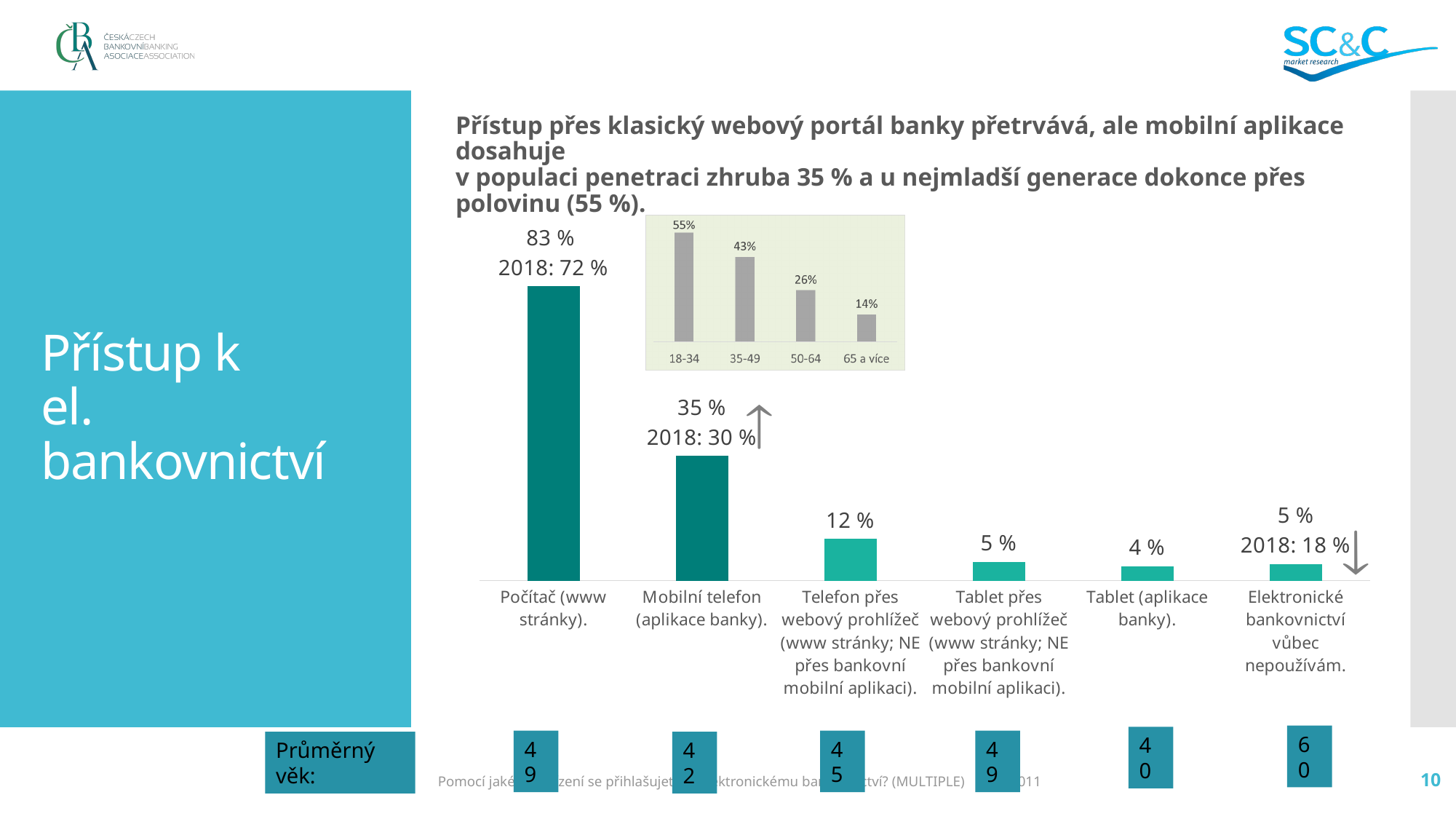
In the small inset chart, what is the value for the 18-34 age group? 55% In the main bar chart, what is the value for Mobilní telefon (aplikace banky)? 35 % What kind of chart is the main chart on the slide? Bar chart How many categories does the main bar chart show? 6 In the main bar chart, what was the 2018 value shown for Elektronické bankovnictví vůbec nepoužívám? 2018: 18 % In the small inset chart, which age group has the lowest value? 65 a více In the main bar chart, what is the difference between Počítač (www stránky) and Mobilní telefon (aplikace banky)? 48 % In the main bar chart, what is the value for Počítač (www stránky)? 83 % In the small inset chart, do the values rise or fall from 18-34 to 65 a více? Fall In the main bar chart, which category has the highest value? Počítač (www stránky) In the main bar chart, what is the value for Tablet (aplikace banky)? 4 % In the main bar chart, which is larger: Telefon přes webový prohlížeč or Tablet přes webový prohlížeč? Telefon přes webový prohlížeč